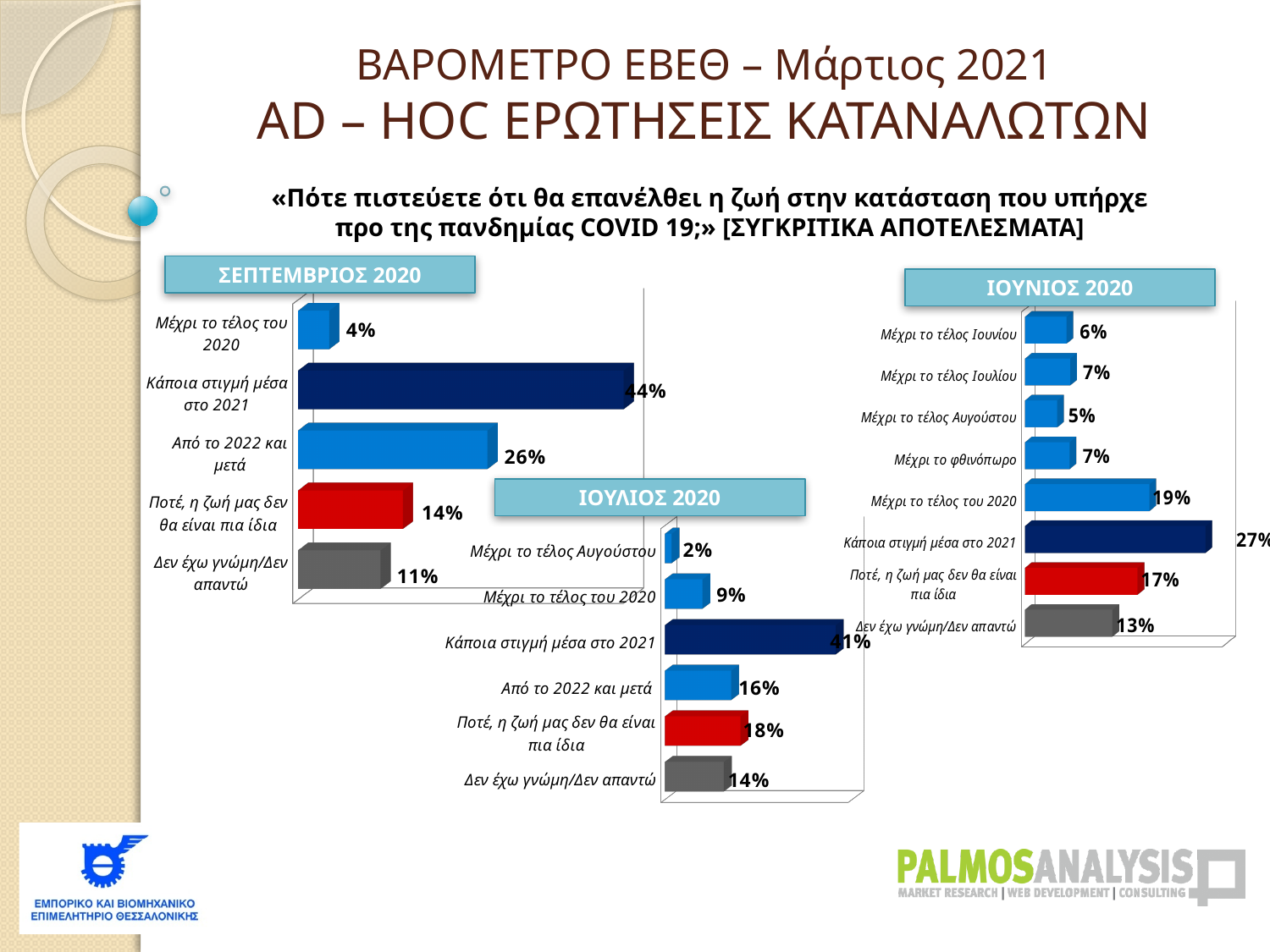
How many categories are shown in the ΣΕΠΤΕΜΒΡΙΟΣ 2020 chart? 5 In the ΣΕΠΤΕΜΒΡΙΟΣ 2020 chart, which category has the lowest value? Μέχρι το τέλος του 2020 In the ΙΟΥΛΙΟΣ 2020 chart, which category has the highest value? Κάποια στιγμή μέσα στο 2021 In the ΙΟΥΝΙΟΣ 2020 chart, what is the value for "Μέχρι το τέλος του 2020"? 19% How many categories are shown in the ΙΟΥΛΙΟΣ 2020 chart? 6 How many categories are shown in the ΙΟΥΝΙΟΣ 2020 chart? 8 What type of chart is the ΙΟΥΝΙΟΣ 2020 chart? Bar chart In the ΙΟΥΛΙΟΣ 2020 chart, what is the value for "Μέχρι το τέλος Αυγούστου"? 2% In the ΣΕΠΤΕΜΒΡΙΟΣ 2020 chart, what is the value for "Κάποια στιγμή μέσα στο 2021"? 44% In the ΣΕΠΤΕΜΒΡΙΟΣ 2020 chart, what is the difference between "Από το 2022 και μετά" and "Ποτέ, η ζωή μας δεν θα είναι πια ίδια"? 12% In the ΙΟΥΛΙΟΣ 2020 chart, which is larger: "Από το 2022 και μετά" or "Ποτέ, η ζωή μας δεν θα είναι πια ίδια"? Ποτέ, η ζωή μας δεν θα είναι πια ίδια In the ΙΟΥΝΙΟΣ 2020 chart, which category has the highest value? Κάποια στιγμή μέσα στο 2021